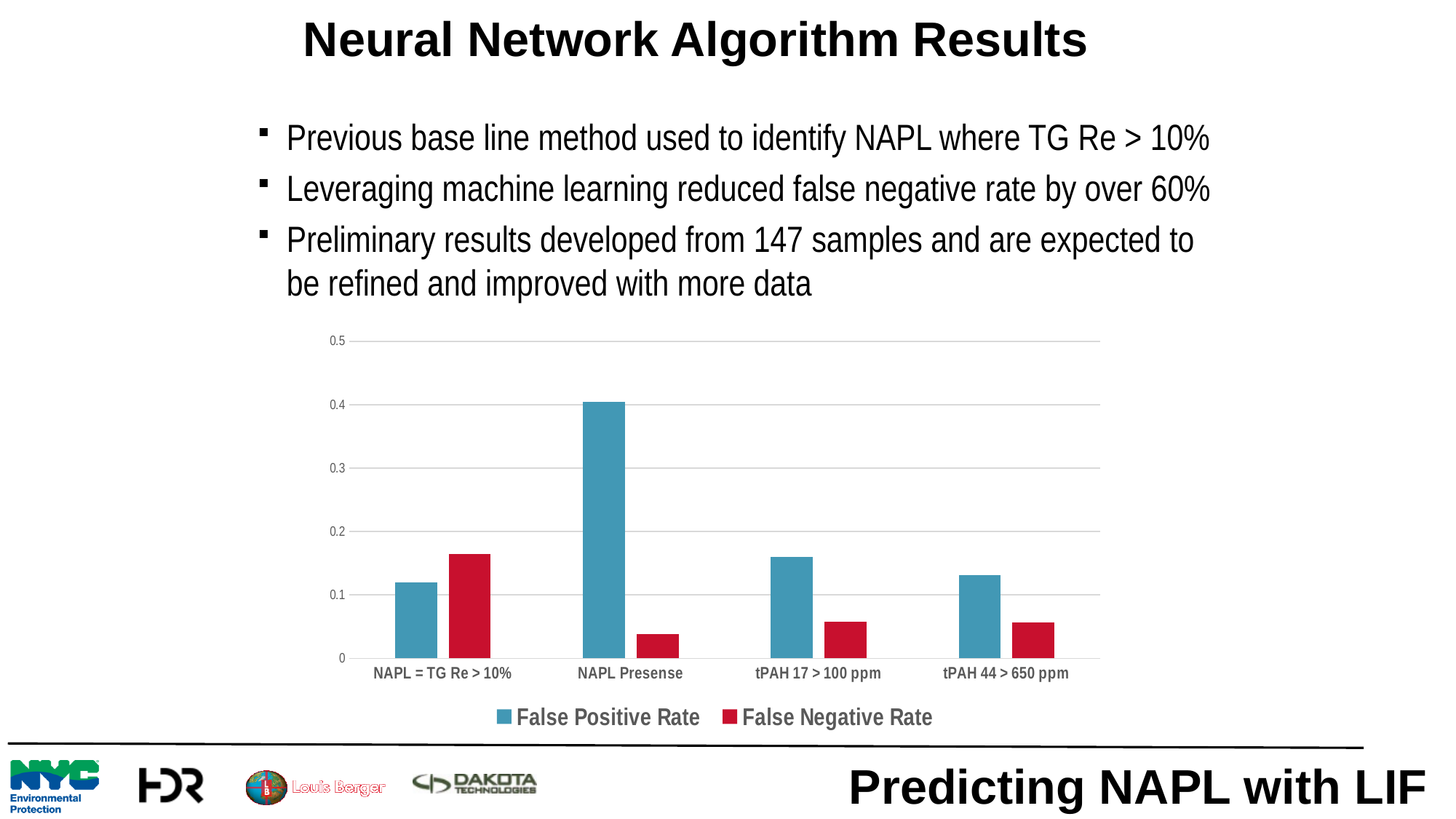
Which category has the lowest False Negative Rate? NAPL Presense Is the False Positive Rate for NAPL Presense greater or less than 0.3? greater For tPAH 17 > 100 ppm, which is larger: the False Positive Rate or the False Negative Rate? False Positive Rate How many series does the chart legend list? 2 Is the False Negative Rate for NAPL Presense greater or less than 0.1? less For NAPL = TG Re > 10%, which is larger: the False Positive Rate or the False Negative Rate? False Negative Rate Is the False Negative Rate for NAPL = TG Re > 10% greater or less than 0.1? greater Which colour represents the False Negative Rate series in the chart? red Which category has the highest False Negative Rate? NAPL = TG Re > 10% Which category has the highest False Positive Rate? NAPL Presense How many categories are shown on the x axis of the chart? 4 What kind of chart is shown on the slide? bar chart